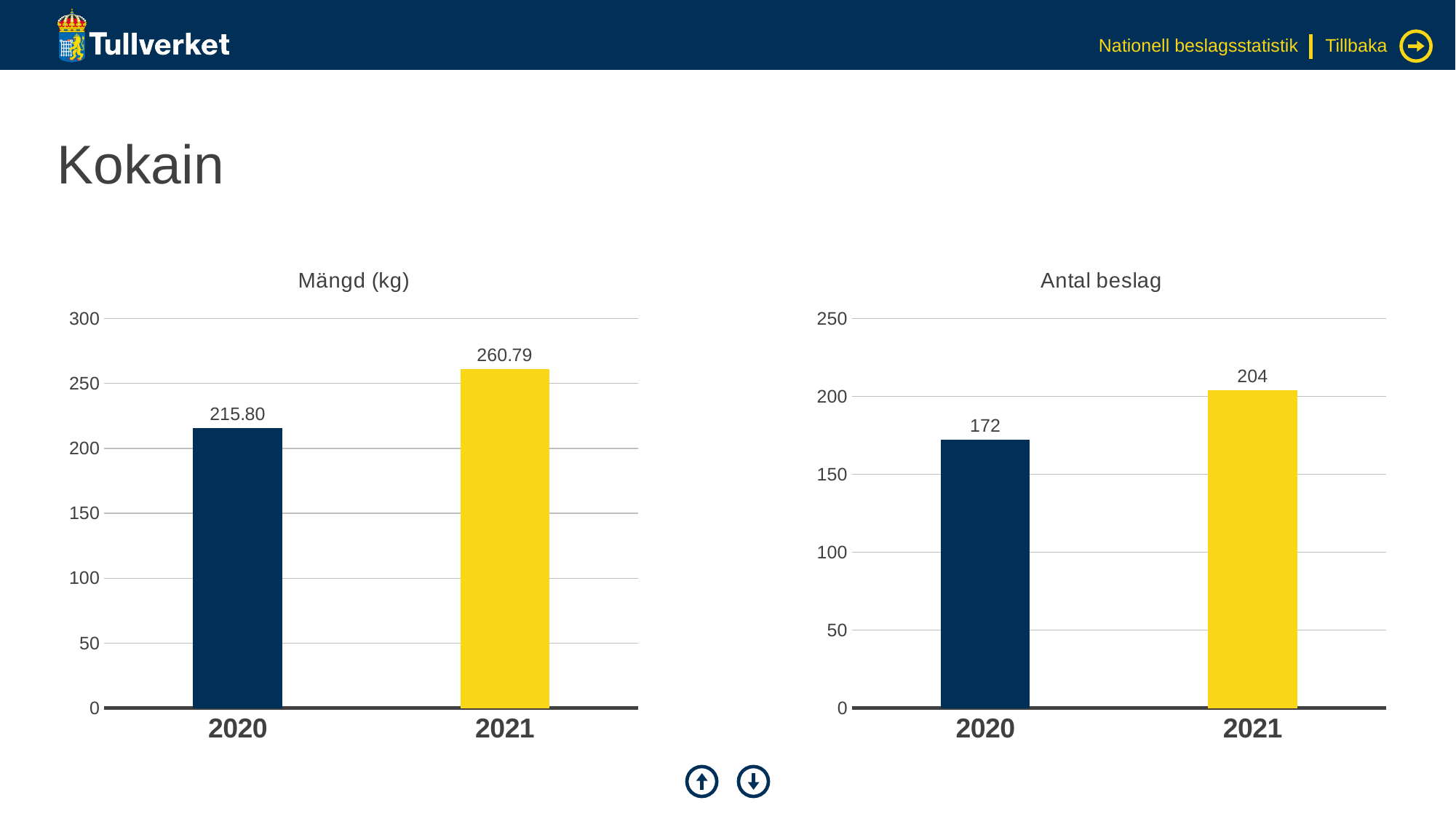
What kind of chart is the 'Antal beslag' chart? bar chart In the 'Antal beslag' chart, is the value for 2020 greater or less than 150? greater In the 'Antal beslag' chart, what is the value for 2021? 204 In the 'Mängd (kg)' chart, what is the difference between the 2021 and 2020 values? 44.99 How many categories are shown on the x axis of the 'Mängd (kg)' chart? 2 In the 'Antal beslag' chart, what is the value for 2020? 172 In the 'Mängd (kg)' chart, what is the value for 2020? 215.80 In the 'Antal beslag' chart, which year has the lowest value? 2020 In the 'Mängd (kg)' chart, which year has the highest value? 2021 In the 'Mängd (kg)' chart, what is the value for 2021? 260.79 In the 'Antal beslag' chart, what is the difference between the 2021 and 2020 values? 32 In the 'Mängd (kg)' chart, do the values rise or fall from 2020 to 2021? rise